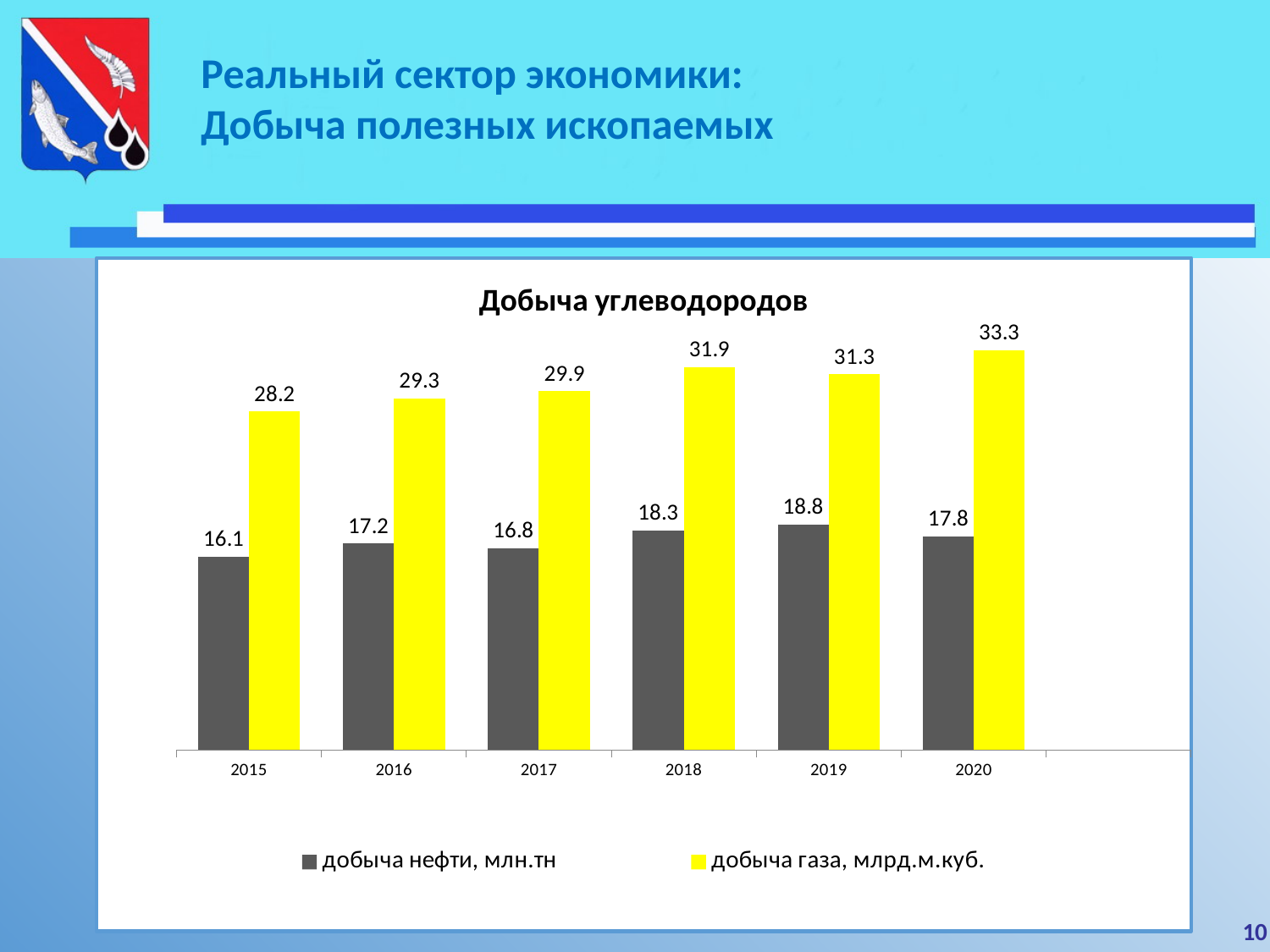
What is the difference between добыча газа, млрд.м.куб. in 2020 and in 2015? 5.1 How many series does the legend list? 2 What is the difference between добыча нефти, млн.тн in 2019 and in 2020? 1.0 How many years are shown on the x axis? 6 In which year is добыча газа, млрд.м.куб. lowest? 2015 What is the title of the chart? Добыча углеводородов What kind of chart is this? bar chart In which year is добыча нефти, млн.тн highest? 2019 What is the value for добыча газа, млрд.м.куб. in 2020? 33.3 What is the value for добыча газа, млрд.м.куб. in 2017? 29.9 Which is larger: добыча нефти, млн.тн in 2016 or in 2017? 2016 What is the value for добыча нефти, млн.тн in 2015? 16.1